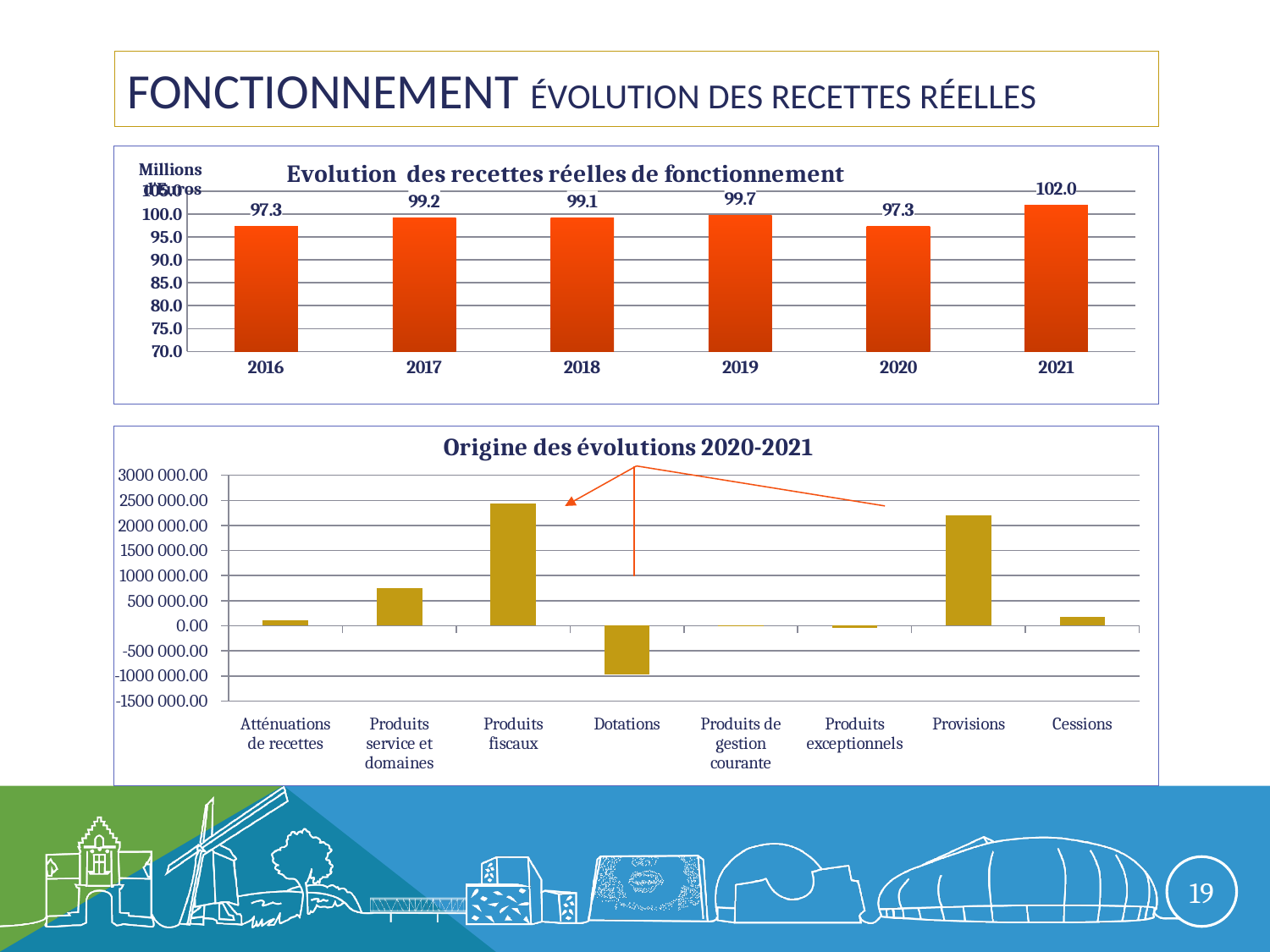
In the chart 'Evolution des recettes réelles de fonctionnement', what is the value for 2019? 99.7 In the chart 'Origine des évolutions 2020-2021', is the value for Provisions greater or less than 2000 000.00? greater In the chart 'Evolution des recettes réelles de fonctionnement', how many years are shown on the x axis? 6 In the chart 'Origine des évolutions 2020-2021', which category has the highest value? Produits fiscaux In the chart 'Origine des évolutions 2020-2021', how many categories are shown on the x axis? 8 In the chart 'Evolution des recettes réelles de fonctionnement', what is the difference between the 2021 value and the 2020 value? 4.7 In the chart 'Evolution des recettes réelles de fonctionnement', which is larger, the value for 2017 or the value for 2018? 2017 In the chart 'Evolution des recettes réelles de fonctionnement', which year has the highest value? 2021 What kind of chart is 'Evolution des recettes réelles de fonctionnement'? bar chart In the chart 'Origine des évolutions 2020-2021', which category has the lowest value? Dotations In the chart 'Evolution des recettes réelles de fonctionnement', what is the value for 2021? 102.0 In the chart 'Origine des évolutions 2020-2021', is the value for Produits service et domaines greater or less than 1000 000.00? less